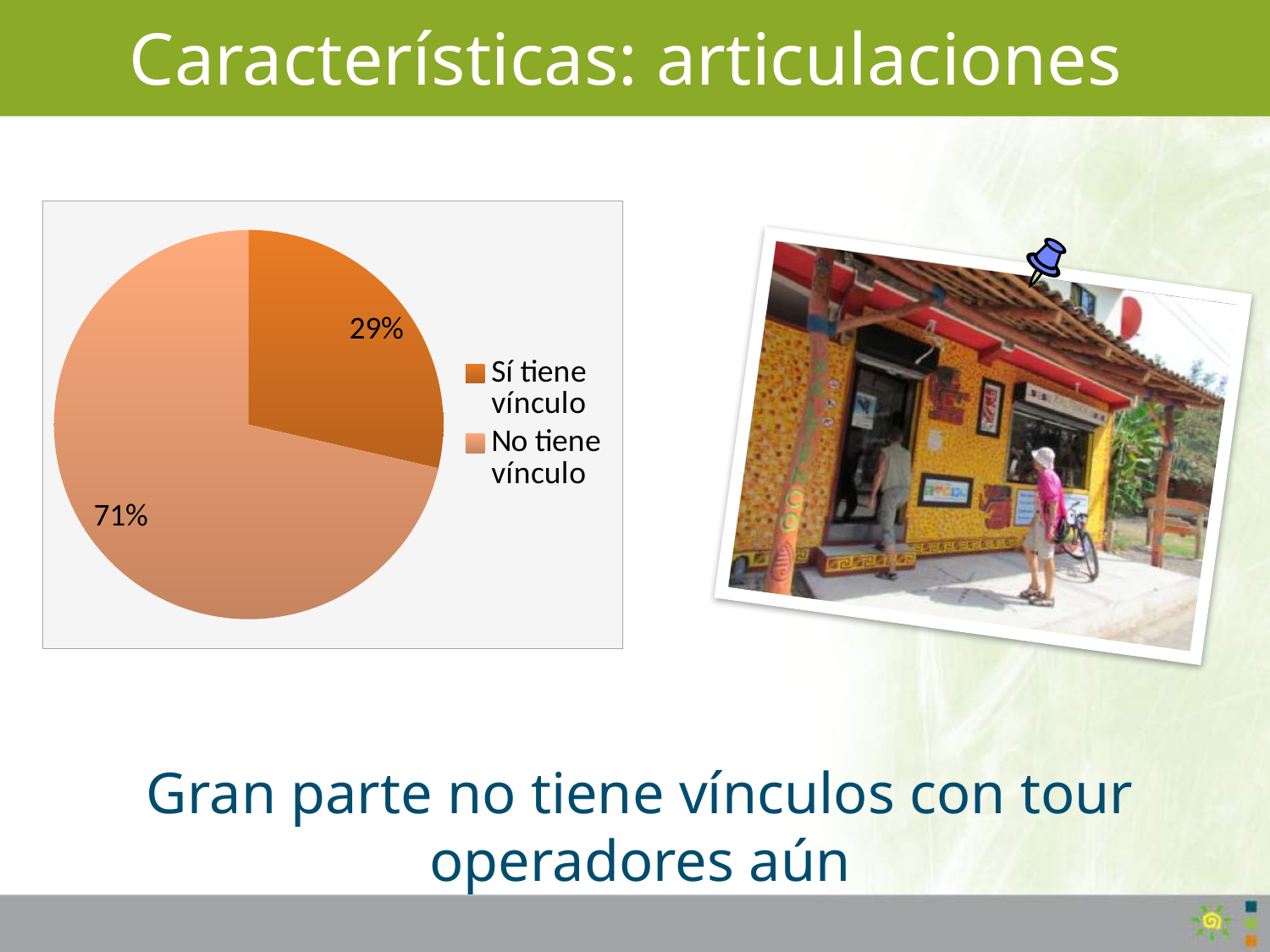
How many entries does the legend list? 2 Which is larger, the share for "Sí tiene vínculo" or for "No tiene vínculo"? No tiene vínculo How many slices does the pie chart have? 2 Which legend entry is shown in the lighter orange colour? No tiene vínculo What kind of chart is shown on the slide? pie chart Which category has the smallest slice of the pie? Sí tiene vínculo What is the difference in percentage points between "No tiene vínculo" and "Sí tiene vínculo"? 42 What share of the pie does "No tiene vínculo" represent? 71% Where is the legend positioned relative to the pie? to the right What share of the pie does "Sí tiene vínculo" represent? 29% Which category has the largest slice of the pie? No tiene vínculo What is the value printed on the darker orange slice? 29%